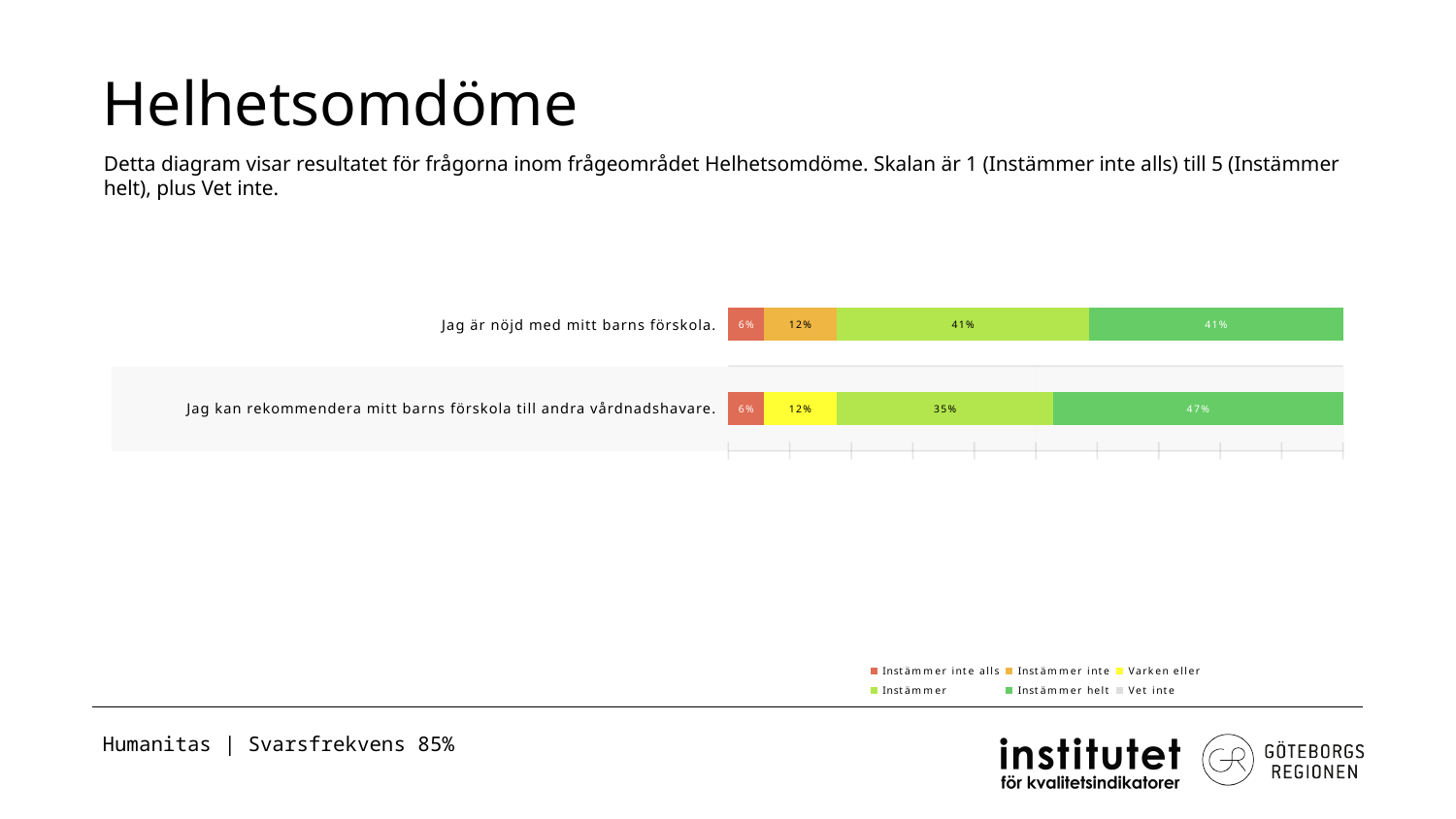
What is the difference in the 'Instämmer helt' share between 'Jag kan rekommendera mitt barns förskola till andra vårdnadshavare.' and 'Jag är nöjd med mitt barns förskola.'? 6 percentage points What percentage answered 'Instämmer' for 'Jag kan rekommendera mitt barns förskola till andra vårdnadshavare.'? 35% What percentage answered 'Instämmer inte alls' for 'Jag är nöjd med mitt barns förskola.'? 6% Which statement has the larger 'Instämmer helt' share? Jag kan rekommendera mitt barns förskola till andra vårdnadshavare. How many statements (categories) are plotted in the chart? 2 How many series does the chart legend list? 6 What is the title of the slide containing the chart? Helhetsomdöme What is the difference in the 'Instämmer' share between 'Jag är nöjd med mitt barns förskola.' and 'Jag kan rekommendera mitt barns förskola till andra vårdnadshavare.'? 6 percentage points What is the total of the labelled segments in the bar for 'Jag är nöjd med mitt barns förskola.'? 100% What percentage answered 'Instämmer helt' for 'Jag kan rekommendera mitt barns förskola till andra vårdnadshavare.'? 47% What percentage answered 'Instämmer helt' for 'Jag är nöjd med mitt barns förskola.'? 41% What kind of chart is shown on the slide? Bar chart